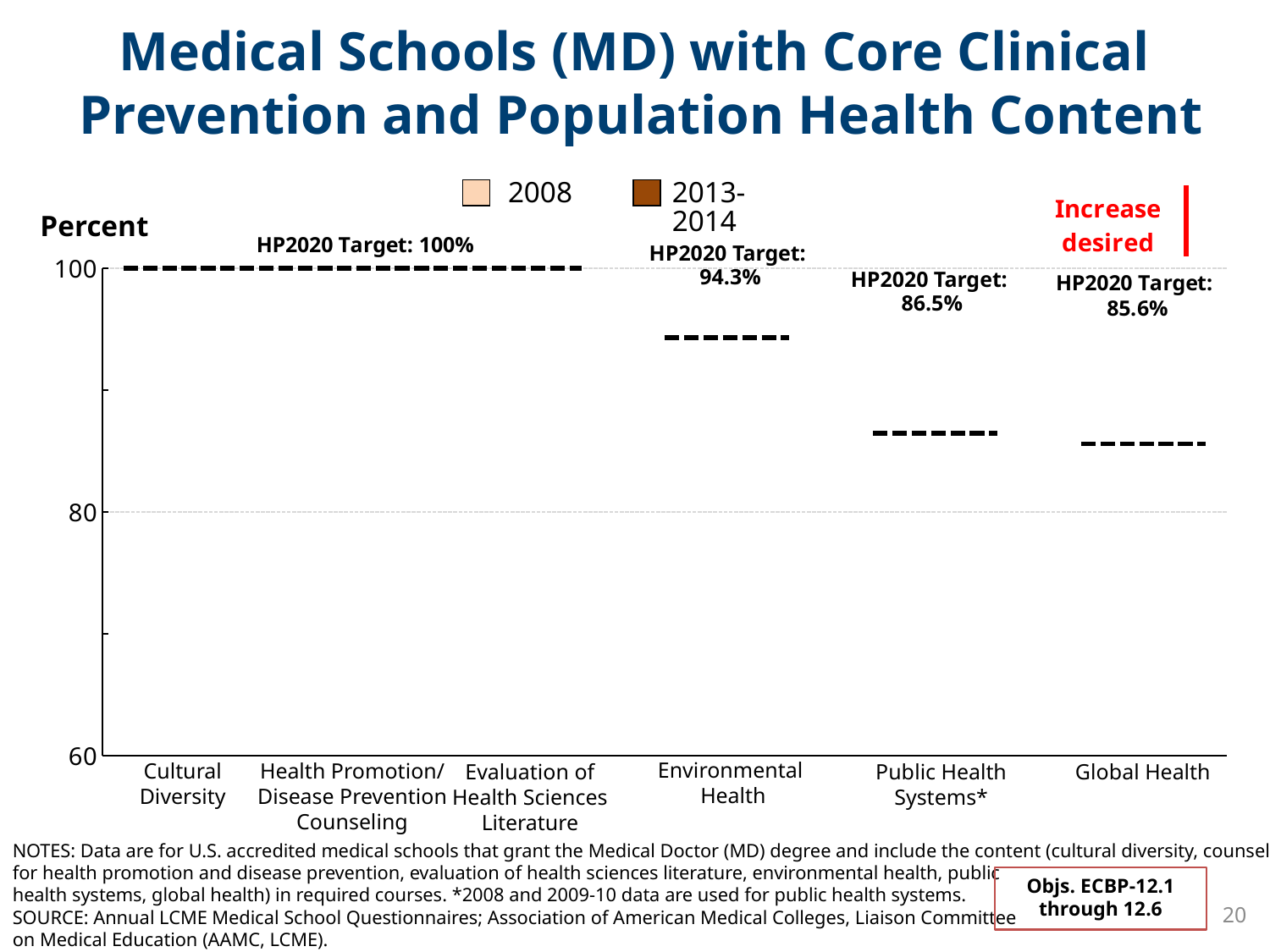
What are the two series named in the chart's legend? 2008 and 2013-2014 How many categories are shown along the x axis of the chart? 6 What is the HP2020 Target shown for Environmental Health? 94.3% What is the difference between the HP2020 Target for Environmental Health and the HP2020 Target for Public Health Systems? 7.8 percentage points What is the HP2020 Target shown for Global Health? 85.6% What is the HP2020 Target shown for Cultural Diversity? 100% Which category has the lowest HP2020 Target shown on the chart? Global Health What is the HP2020 Target shown for Public Health Systems? 86.5% What is the label on the chart's vertical axis? Percent Which is larger, the HP2020 Target for Public Health Systems or the HP2020 Target for Global Health? Public Health Systems What is the lowest value shown on the chart's vertical axis? 60 How many series does the chart's legend list? 2